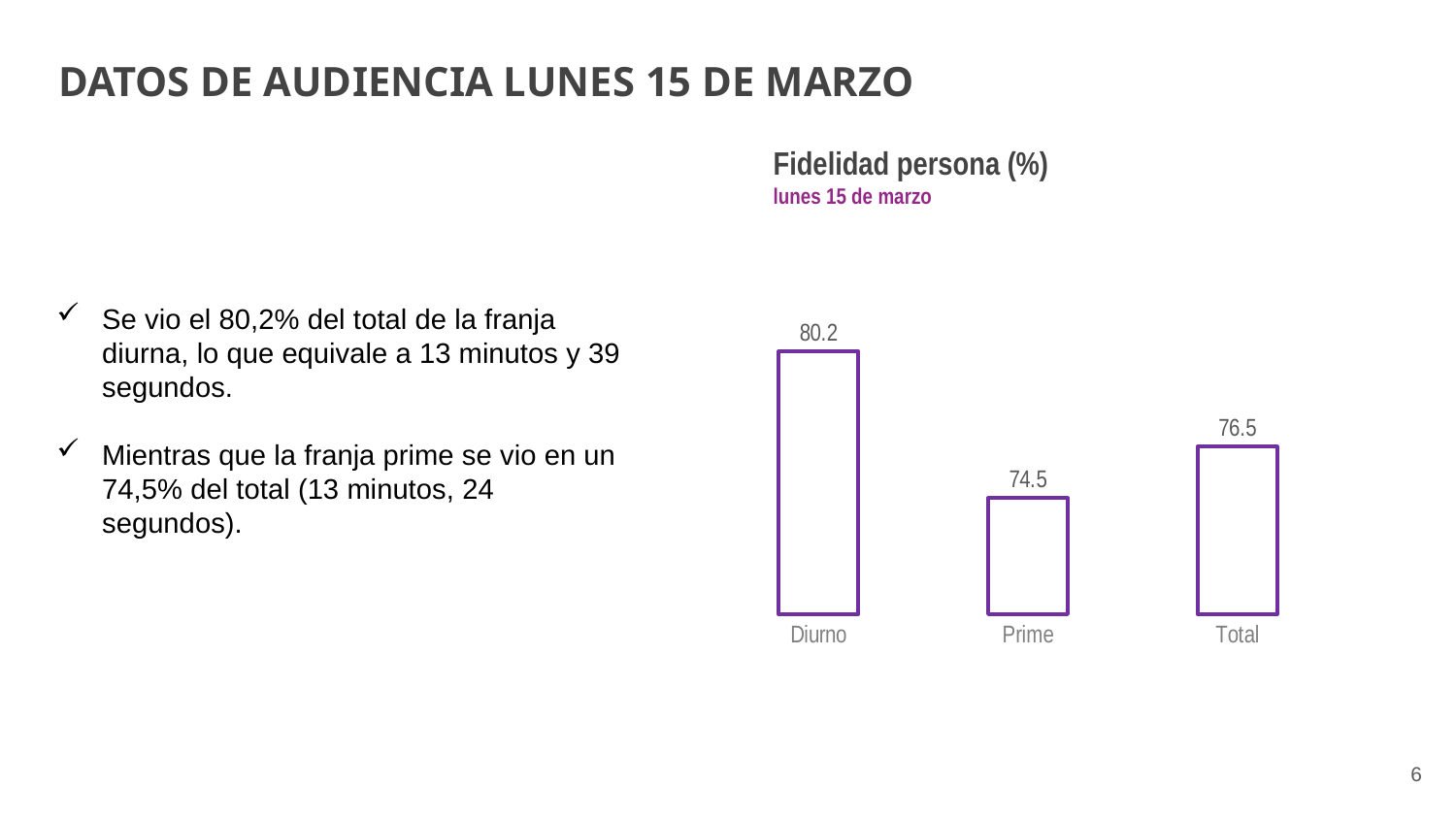
What is the value for Diurno in the Fidelidad persona (%) chart? 80.2 What is the difference between the Diurno and Total values in the Fidelidad persona (%) chart? 3.7 How many categories are shown in the Fidelidad persona (%) chart? 3 Which is larger in the Fidelidad persona (%) chart, Prime or Total? Total What is the value for Total in the Fidelidad persona (%) chart? 76.5 What is the title of the chart on the slide? Fidelidad persona (%) What is the difference between the Diurno and Prime values in the Fidelidad persona (%) chart? 5.7 What date is shown in the subtitle of the Fidelidad persona (%) chart? lunes 15 de marzo Which category has the lowest value in the Fidelidad persona (%) chart? Prime What is the value for Prime in the Fidelidad persona (%) chart? 74.5 What kind of chart is the Fidelidad persona (%) chart? Bar chart Which category has the highest value in the Fidelidad persona (%) chart? Diurno